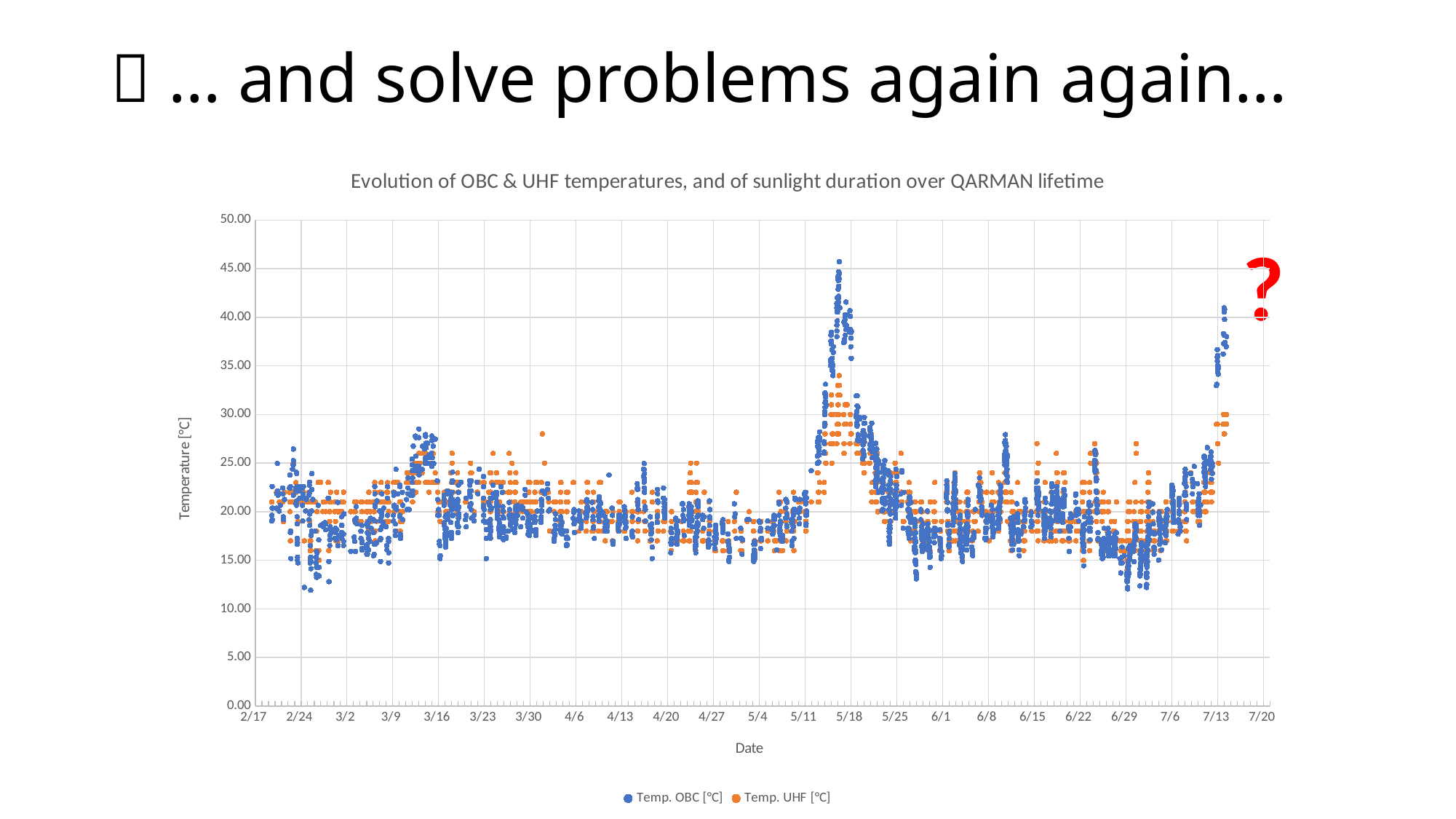
Are the lowest Temp. OBC values around 6/29 greater or less than 15.00? less What kind of chart is shown on the slide? Scatter chart Are the highest Temp. OBC values just after 7/13 greater or less than 35.00? greater How many series does the legend list? 2 Is the peak value of Temp. UHF around 5/18 greater or less than 30.00? greater What is the title of the chart? Evolution of OBC & UHF temperatures, and of sunlight duration over QARMAN lifetime Do the Temp. OBC values rise or fall between 5/18 and 5/25? fall What is the highest value shown on the temperature axis? 50.00 Around 5/18, which series shows higher temperatures, Temp. OBC or Temp. UHF? Temp. OBC What are the two series named in the legend? Temp. OBC [°C] and Temp. UHF [°C] Which series reaches the highest temperature on the chart? Temp. OBC [°C]